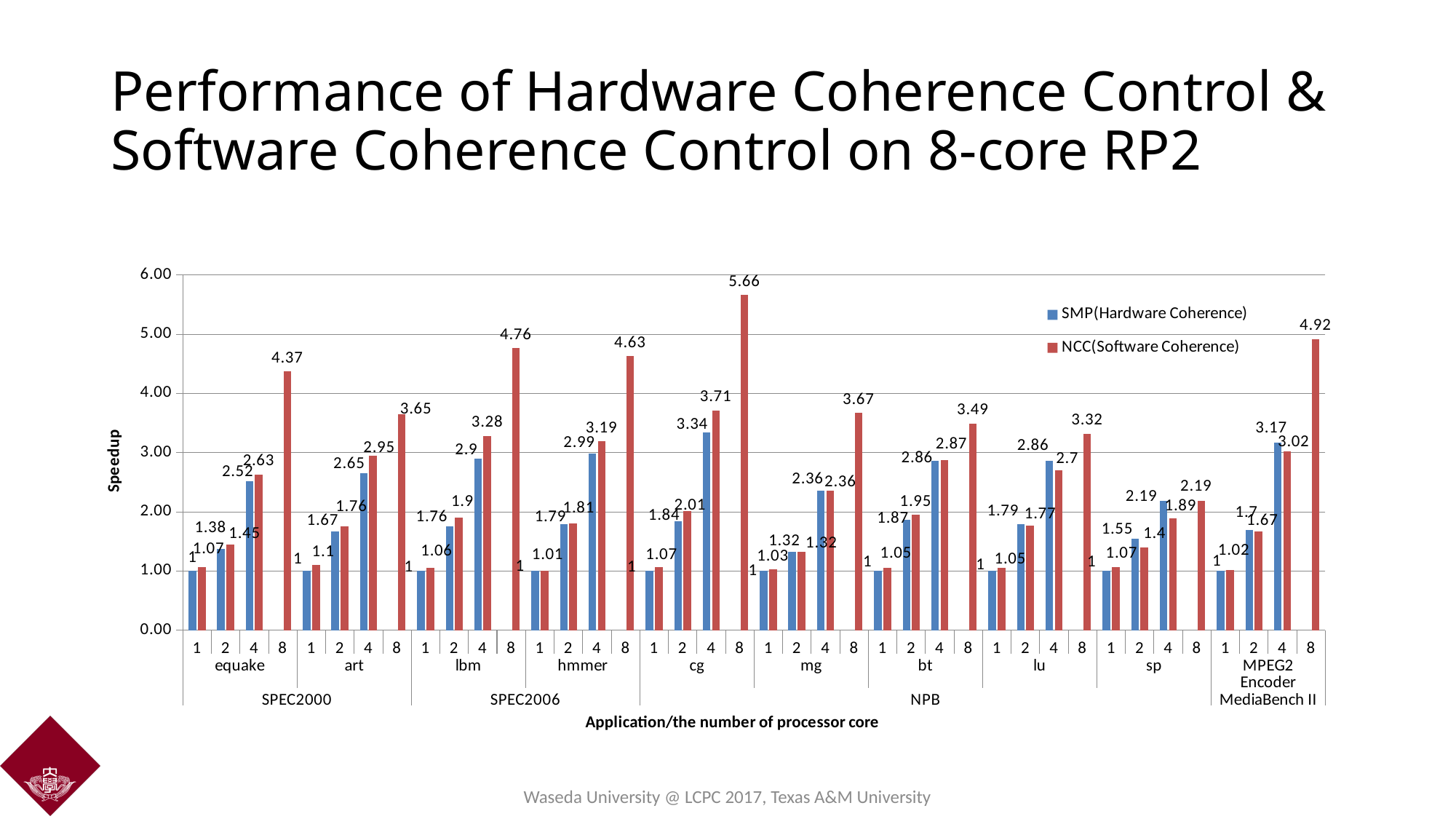
Which application has the highest NCC(Software Coherence) speedup at 8 cores? cg Is the NCC(Software Coherence) speedup for hmmer with 8 cores greater or less than 4.00? greater For sp with 4 cores, which is larger: the SMP(Hardware Coherence) speedup or the NCC(Software Coherence) speedup? SMP(Hardware Coherence) How many series does the legend list? 2 What is the difference between the NCC(Software Coherence) and SMP(Hardware Coherence) speedups for cg with 4 cores? 0.37 How many applications are shown along the x axis of the chart? 10 Which application has the lowest NCC(Software Coherence) speedup at 8 cores? sp What kind of chart is shown on the slide? Bar chart What is the NCC(Software Coherence) speedup for cg with 8 processor cores? 5.66 What is the NCC(Software Coherence) speedup for MPEG2 Encoder with 8 processor cores? 4.92 What is the SMP(Hardware Coherence) speedup for lbm with 4 processor cores? 2.9 What is the label of the y axis of the chart? Speedup